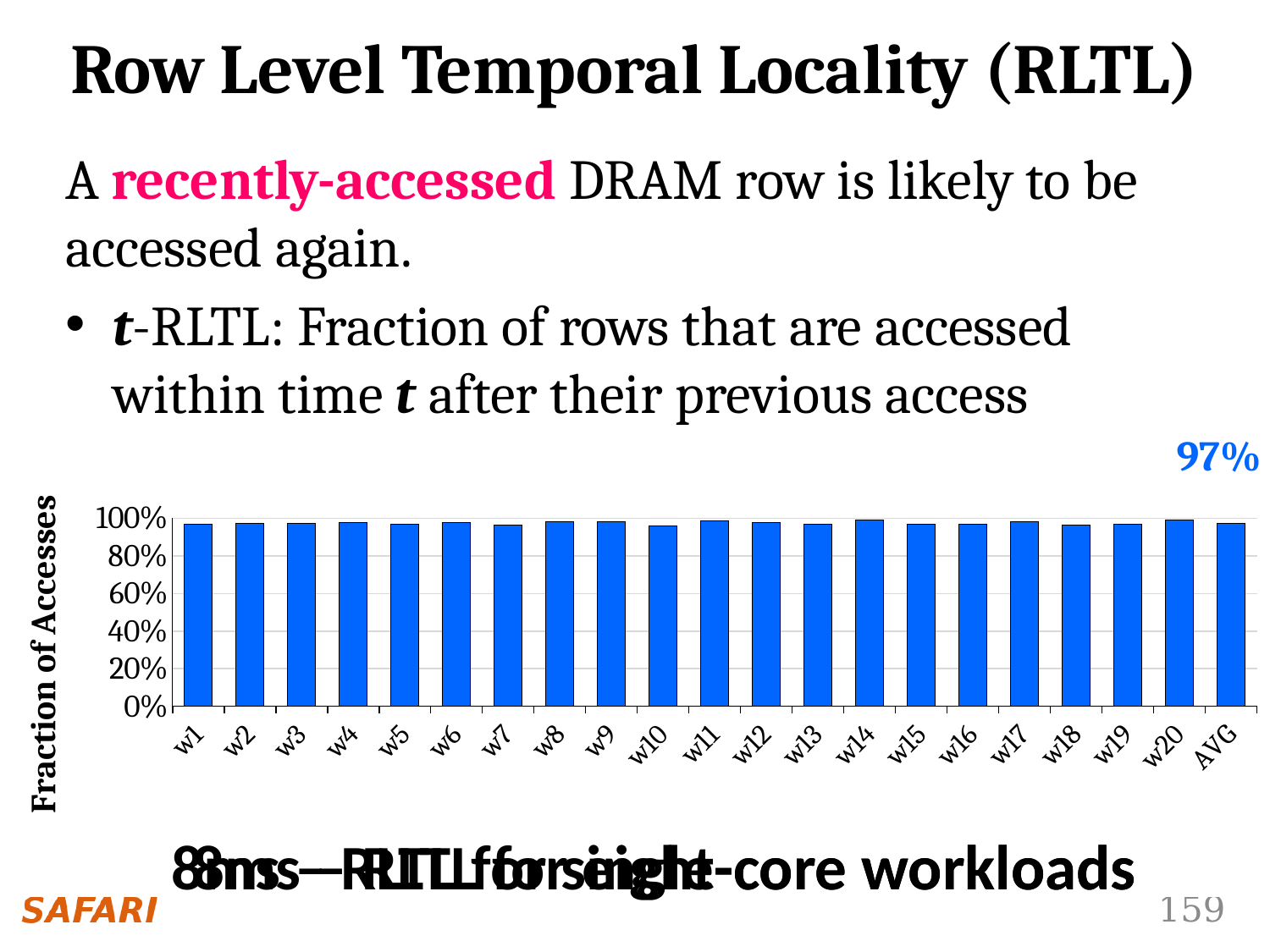
Is the value for AVG greater or less than 80%? greater What is the highest tick value shown on the y axis of the chart? 100% What is the label of the y axis of the chart? Fraction of Accesses What value is annotated above the AVG bar in the chart? 97% What is the first category on the x axis of the chart? w1 What kind of chart is shown on the slide? bar chart Is the value for w10 greater or less than 60%? greater How many categories are shown along the x axis of the chart? 21 Do the bar values rise, fall, or stay roughly flat from w1 to w20? roughly flat Is the value for w1 greater or less than 80%? greater What is the last category on the x axis of the chart? AVG